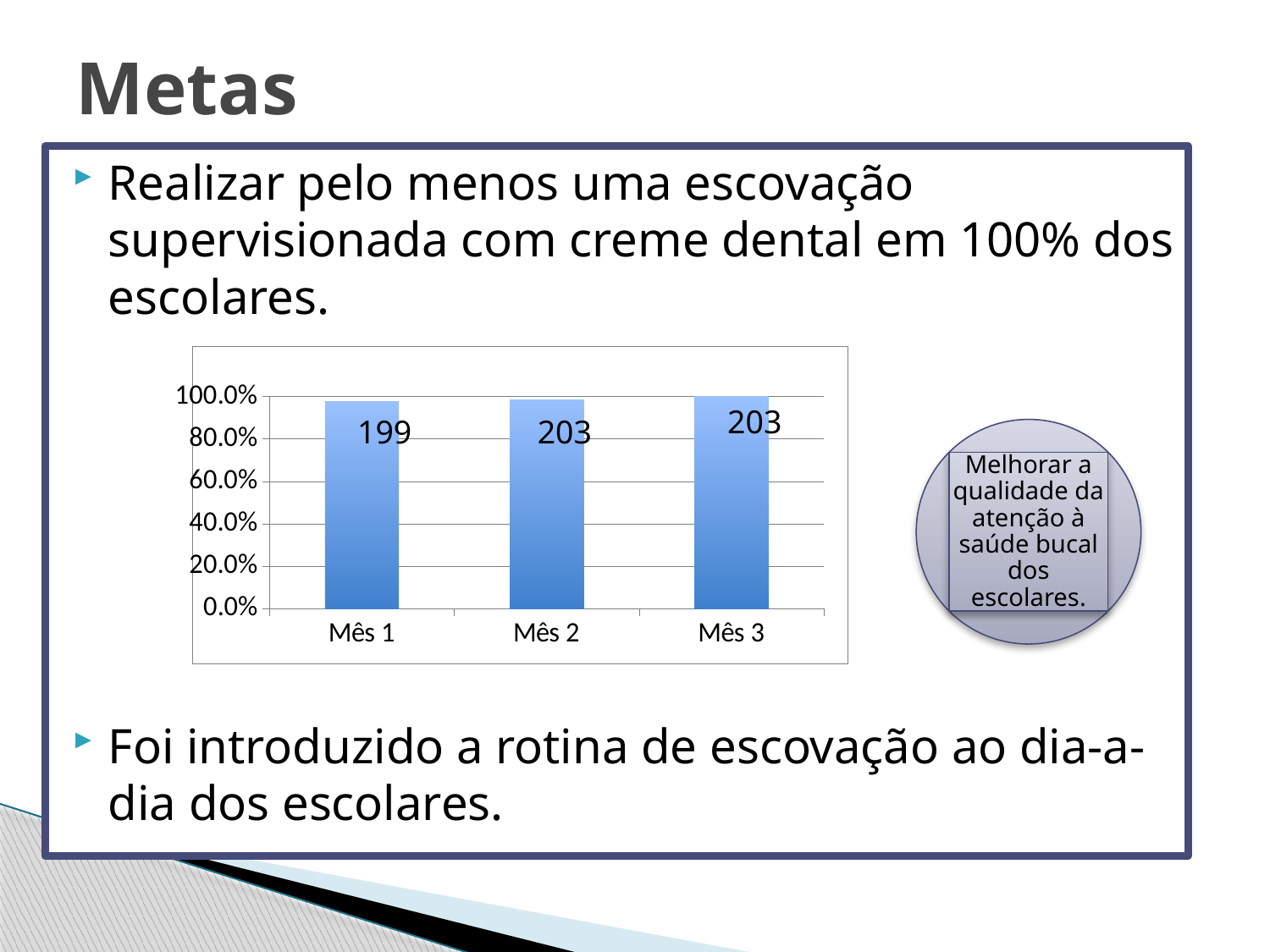
What data label is shown on the bar for Mês 3? 203 What is the difference between the labelled values for Mês 2 and Mês 1? 4 Do the labelled values rise or fall from Mês 1 to Mês 2? rise Which has the larger labelled value, Mês 1 or Mês 2? Mês 2 Is the bar for Mês 1 greater or less than 80.0% on the y axis? greater What is the highest tick value shown on the y axis of the chart? 100.0% What kind of chart is shown on the slide? bar chart What data label is shown on the bar for Mês 1? 199 What data label is shown on the bar for Mês 2? 203 Is the bar for Mês 2 greater or less than 60.0% on the y axis? greater Which month has the lowest labelled value in the chart? Mês 1 How many categories (months) are shown on the x axis of the chart? 3